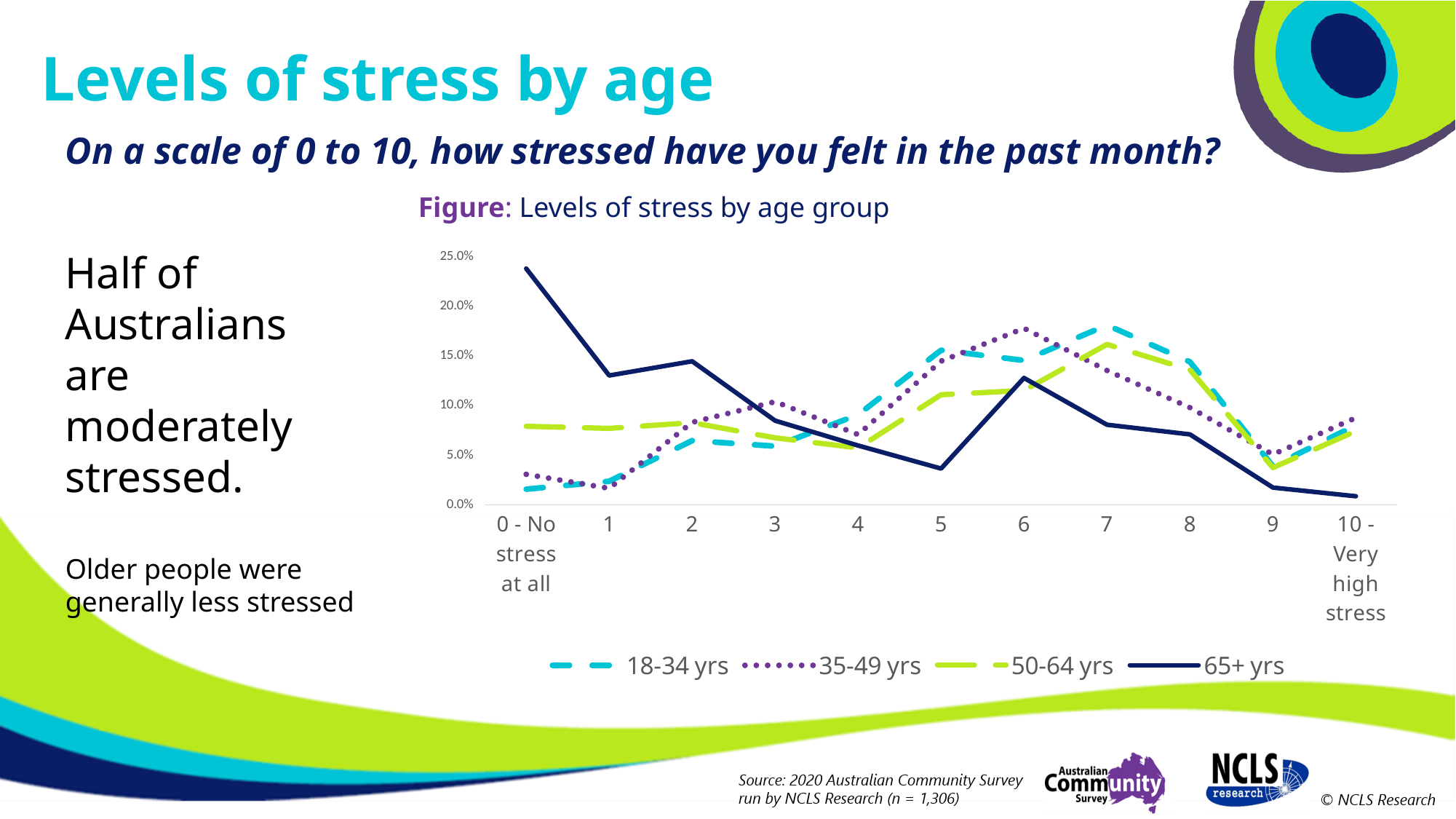
Which age group has the highest value at '0 - No stress at all'? 65+ yrs Does the 65+ yrs line generally rise or fall from '0 - No stress at all' to '10 - Very high stress'? fall At stress level 1, which is larger: the value for 65+ yrs or for 18-34 yrs? 65+ yrs Is the value for 35-49 yrs at stress level 6 greater or less than 15.0%? greater How many series does the legend list? 4 What is the title of the figure? Levels of stress by age group What kind of chart is shown on the slide? line chart Is the value for 65+ yrs at '10 - Very high stress' greater or less than 5.0%? less How many stress-level categories are shown along the x axis? 11 Is the value for 18-34 yrs at '0 - No stress at all' greater or less than 5.0%? less Which age group has the highest value at stress level 6? 35-49 yrs